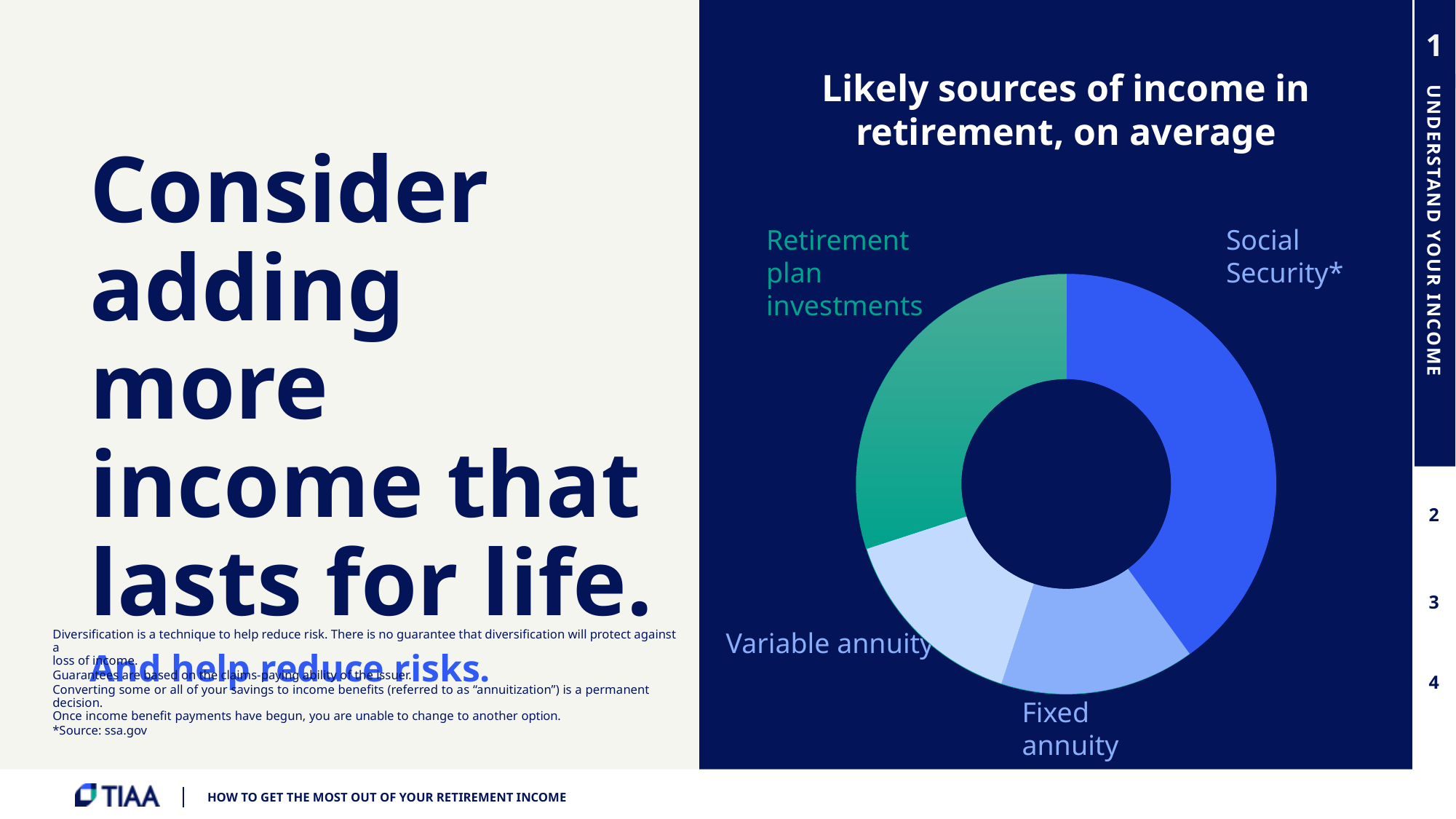
Which income source is shown in green on the chart? Retirement plan investments Which income source has the largest slice in the chart? Social Security* How many income sources (slices) does the chart show? 4 Which slice is larger, Social Security* or Retirement plan investments? Social Security* What is the title of the chart? Likely sources of income in retirement, on average Which slice is larger, Retirement plan investments or Fixed annuity? Retirement plan investments Which slice is larger, Retirement plan investments or Variable annuity? Retirement plan investments What kind of chart is shown on the slide? Donut (pie) chart